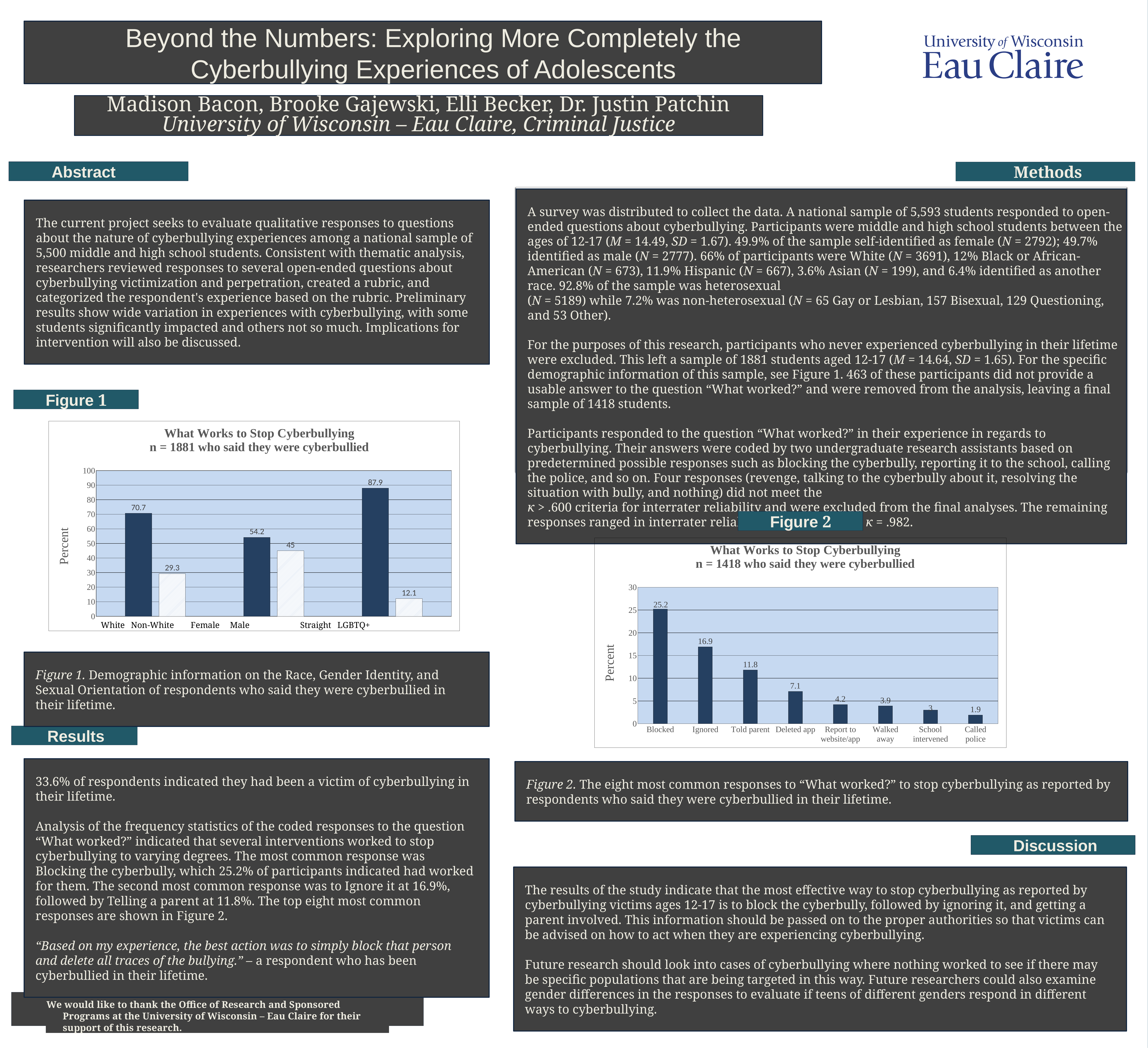
In Figure 2 (the right chart), do the values rise or fall from left to right across the categories? fall In Figure 2 (the right chart), what is the value for Called police? 1.9 In Figure 1 (the left chart), what is the difference between the Female and Male values? 9.2 In Figure 2 (the right chart), how many categories are plotted? 8 In Figure 1 (the left chart), what is the value for LGBTQ+? 12.1 In Figure 2 (the right chart), what is the difference between the Blocked and Ignored values? 8.3 In Figure 2 (the right chart), what is the value for Told parent? 11.8 In Figure 1 (the left chart), which category has the highest value? Straight What kind of chart is Figure 2 (the right chart)? bar chart In Figure 1 (the left chart), which is larger, the value for Non-White or the value for Male? Male In Figure 1 (the left chart), what is the value for White? 70.7 In Figure 2 (the right chart), which category has the lowest value? Called police